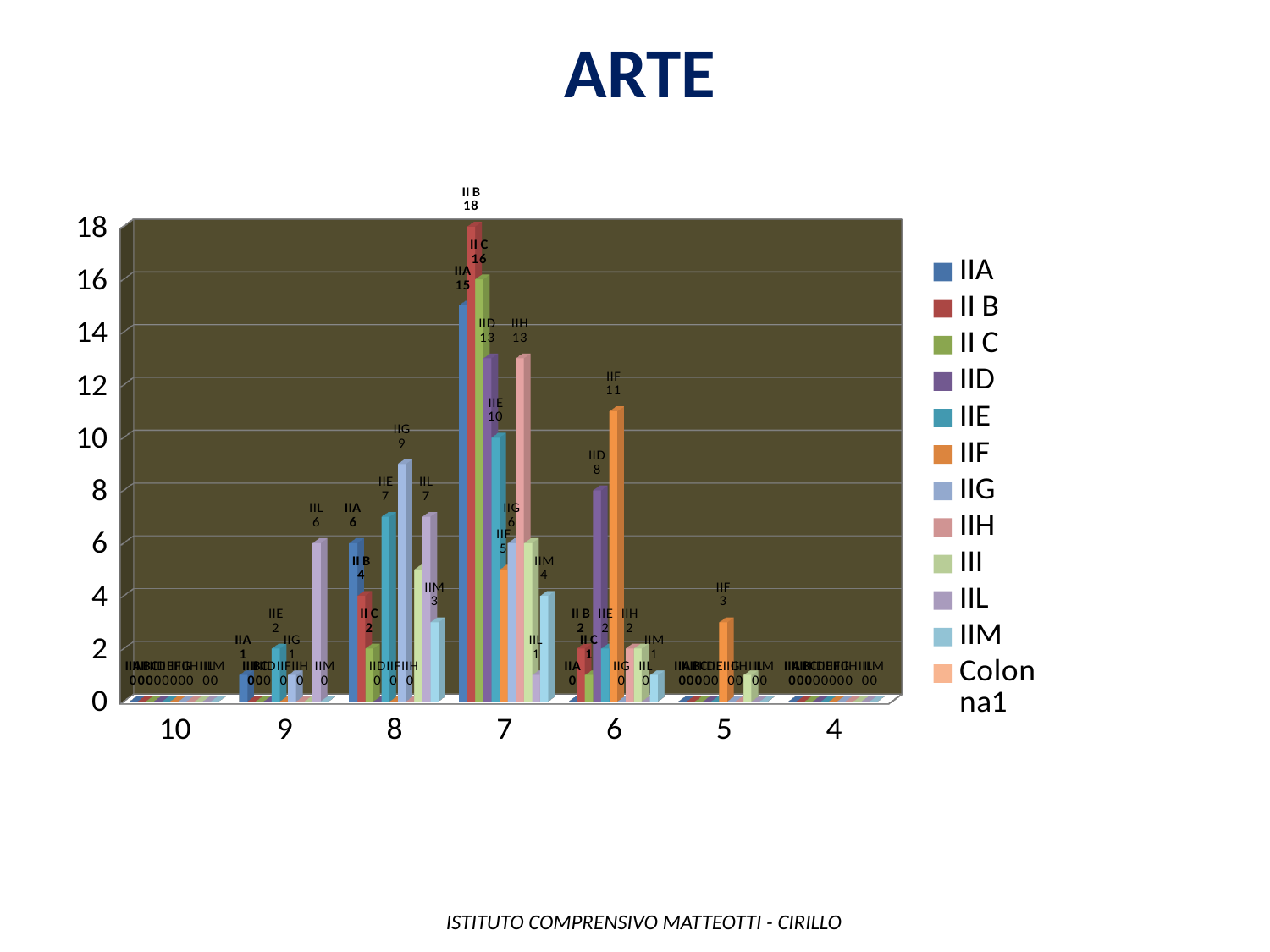
What is the value for IIL at grade 9? 6 What kind of chart is shown on the slide? bar chart What is the difference between II B and IIA at grade 7? 3 How many series does the legend list? 12 What is the value for IIG at grade 8? 9 What is the value for IIF at grade 5? 3 Which series has the highest value at grade 7? II B What is the value for IIF at grade 6? 11 Which series has the highest value at grade 6? IIF What is the value for II B at grade 7? 18 How many grade categories are shown on the x axis? 7 Which is larger at grade 8: IIE or IIA? IIE